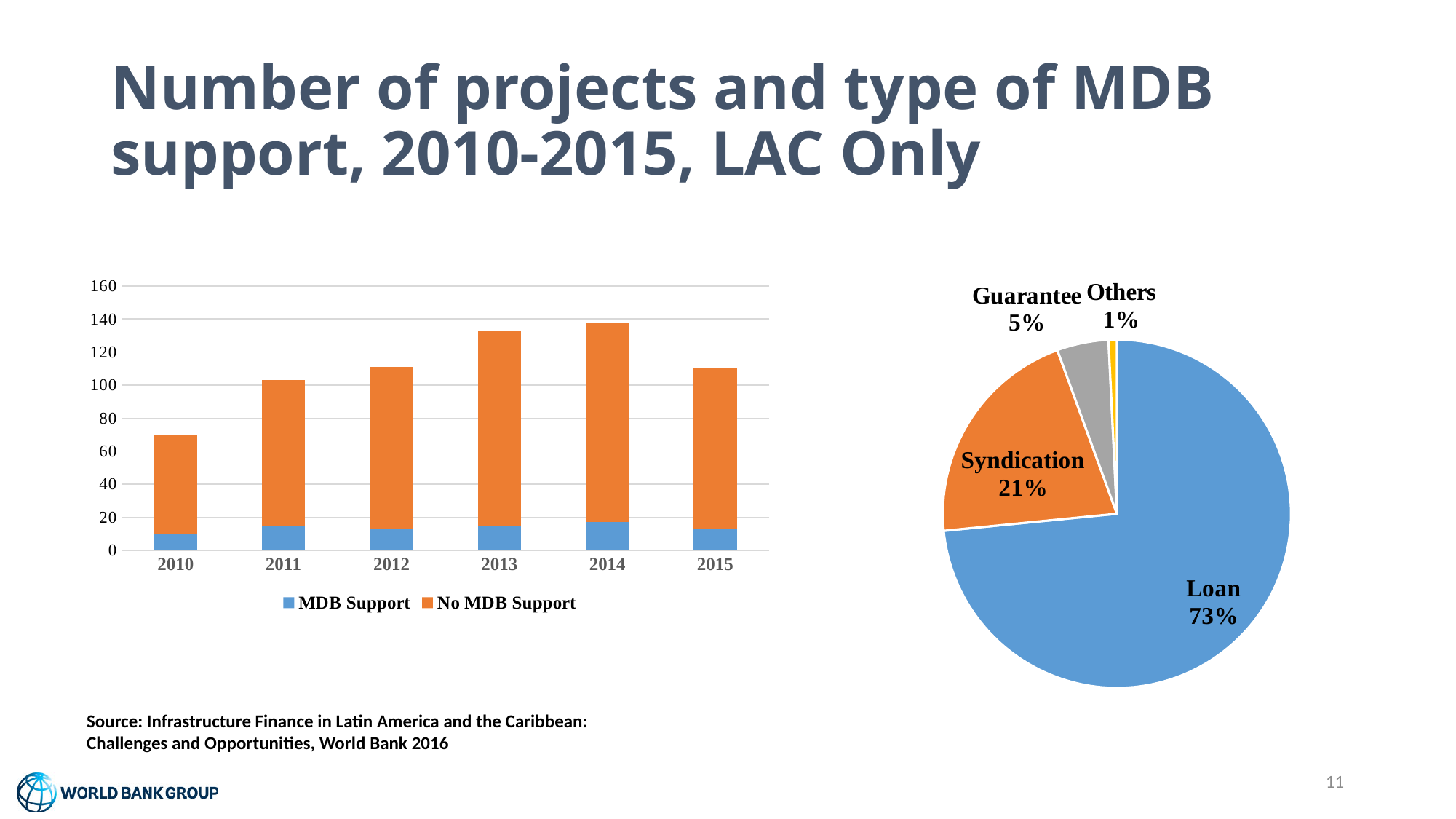
On the pie chart on the right, how many percentage points larger is the Loan share than the Syndication share? 52 On the bar chart on the left, is the total number of projects in 2014 greater or less than 120? greater On the pie chart on the right, what share of MDB support is Loan? 73% On the pie chart on the right, which type of MDB support has the largest share? Loan On the pie chart on the right, what share of MDB support is Syndication? 21% On the bar chart on the left, which series is shown in orange? No MDB Support On the bar chart on the left, which year has the lowest total number of projects? 2010 On the bar chart on the left, how many series does the legend list? 2 On the pie chart on the right, what share of MDB support is Guarantee? 5% On the pie chart on the right, which type of MDB support has the smallest share? Others On the pie chart on the right, how many slices are there? 4 On the bar chart on the left, is the total number of projects in 2010 greater or less than 80? less